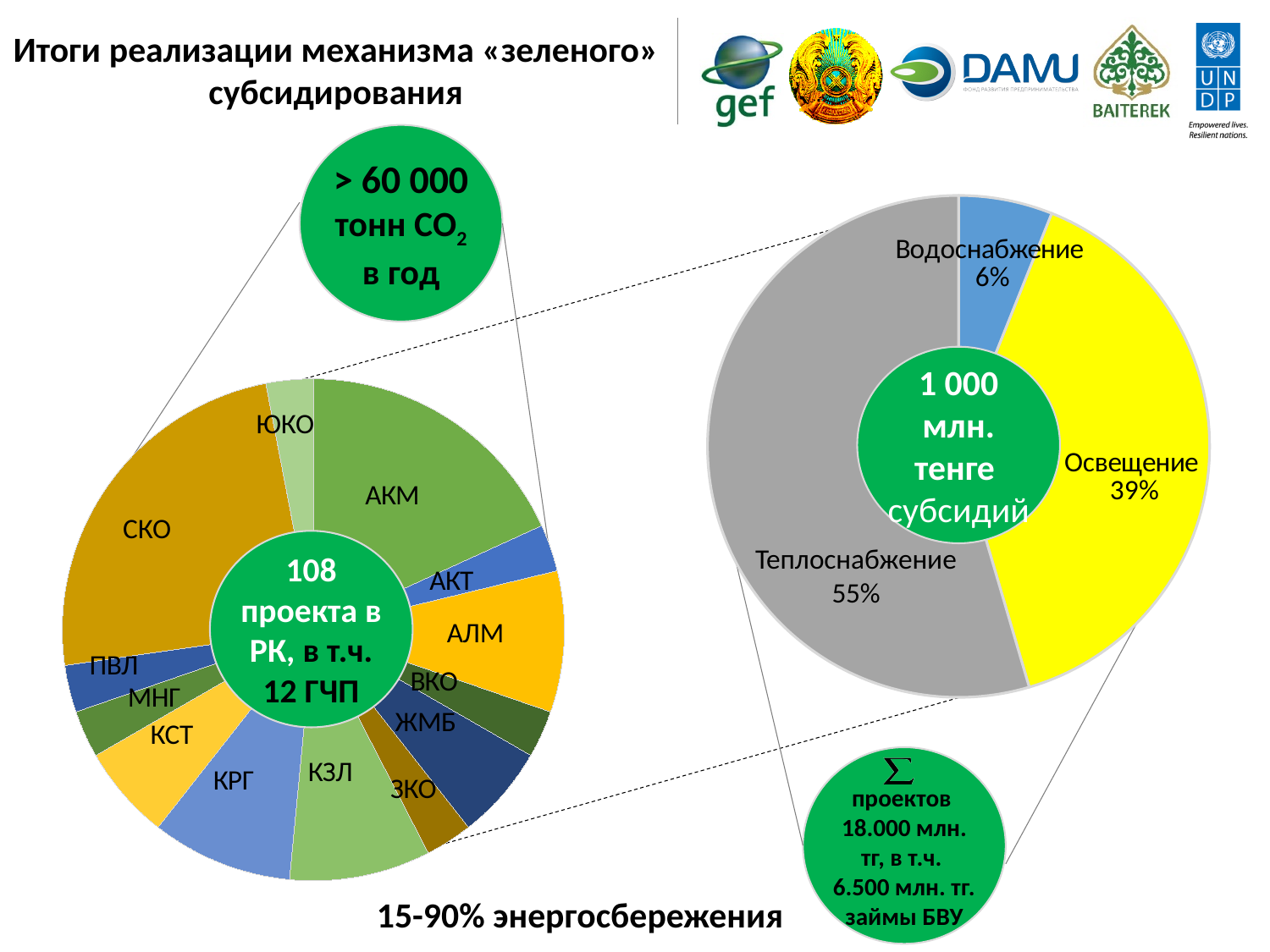
In the right pie chart, which category has the smallest share? Водоснабжение In the right pie chart, what share is shown for Освещение? 39% In the right pie chart, what share is shown for Водоснабжение? 6% In the left pie chart, which slice is larger: СКО or ЮКО? СКО What text is shown in the centre of the left pie chart? 108 проекта в РК, в т.ч. 12 ГЧП What type of chart is the right chart? Pie chart In the right pie chart, which is larger: Освещение or Водоснабжение? Освещение How many regions are labelled in the left pie chart? 13 In the right pie chart, what is the difference in percentage points between Теплоснабжение and Освещение? 16 In the right pie chart, what share is shown for Теплоснабжение? 55% In the right pie chart, which category has the largest share? Теплоснабжение How many categories does the right pie chart show? 3